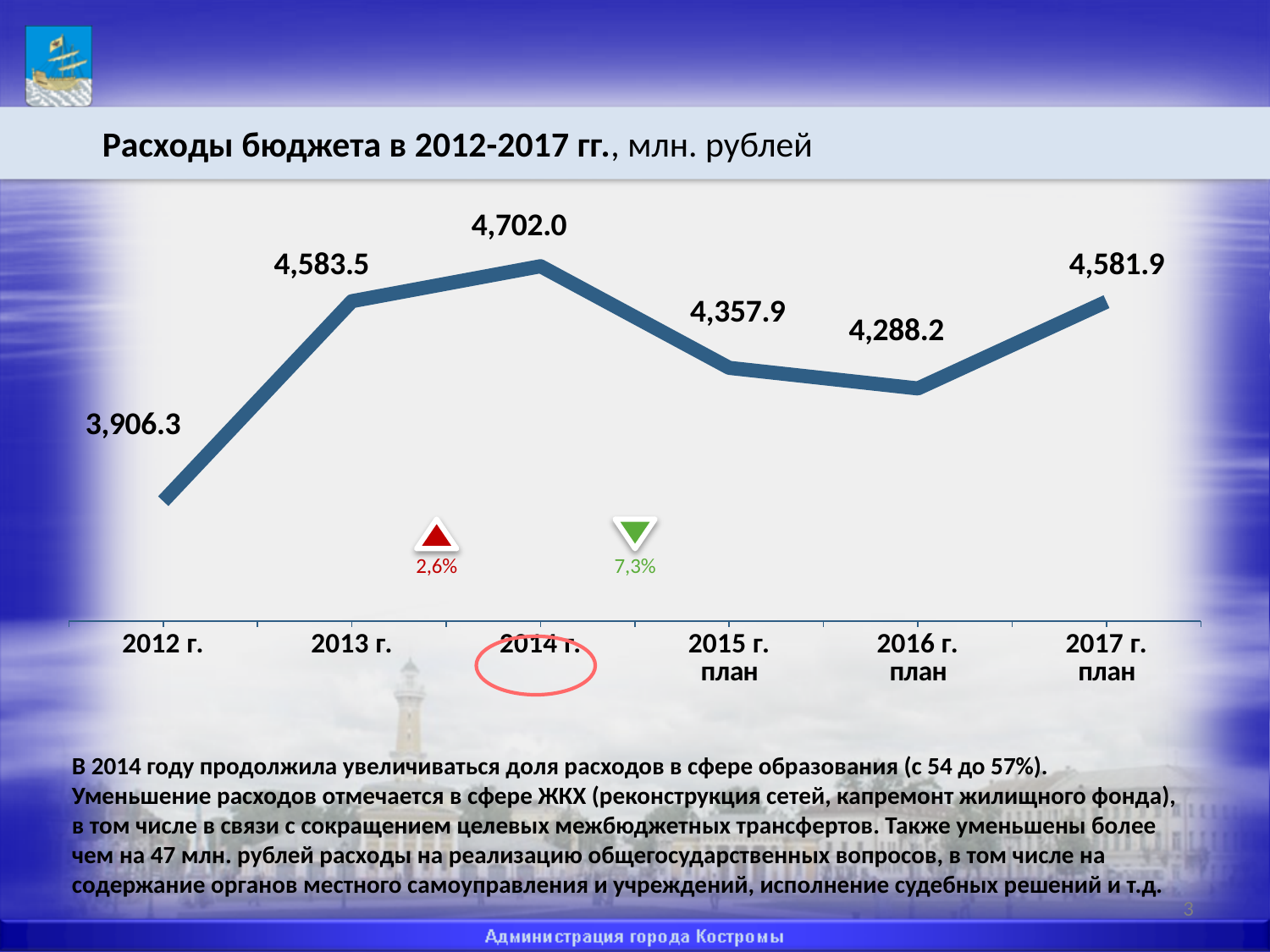
What is the value shown for 2017 г. план? 4,581.9 What is the value shown for 2016 г. план? 4,288.2 Which year has the highest budget expenditure on the chart? 2014 г. What is the value shown for 2014 г.? 4,702.0 What type of chart is shown on the slide? Line chart What is the difference between the values for 2014 г. and 2013 г.? 118.5 What is the title of the chart? Расходы бюджета в 2012-2017 гг., млн. рублей What is the budget expenditure value shown for 2012 г.? 3,906.3 Which year has the lowest budget expenditure on the chart? 2012 г. How many data points are plotted on the chart? 6 What is the difference between the values for 2014 г. and 2015 г. план? 344.1 Which is larger, the value for 2015 г. план or the value for 2016 г. план? 2015 г. план